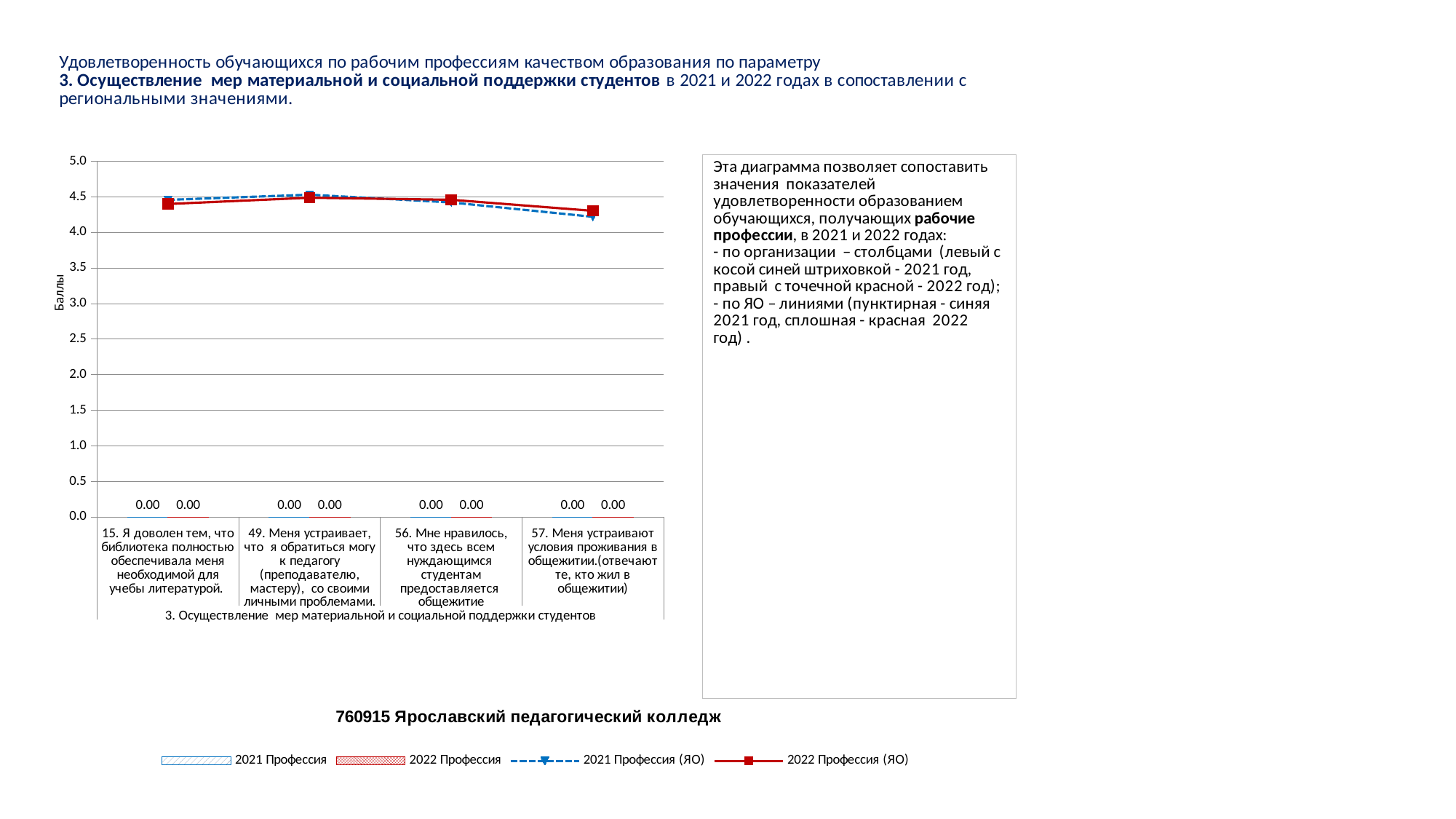
How many categories are shown on the x axis of the chart? 4 What is the value of the 2022 Профессия bar for category "57. Меня устраивают условия проживания в общежитии"? 0.00 What is the label of the vertical axis of the chart? Баллы Which is larger for the 2021 Профессия (ЯО) line: the value for category 15 or the value for category 57? Category 15 What is the value of the 2021 Профессия bar for category "15. Я доволен тем, что библиотека полностью обеспечивала меня необходимой для учебы литературой."? 0.00 What kind of chart is shown on the slide? A combined bar and line chart How many series does the chart legend list? 4 For which category is the 2021 Профессия (ЯО) line lowest? 57. Меня устраивают условия проживания в общежитии Is the value of the 2022 Профессия (ЯО) line for category 15 greater or less than 4.0? greater What is the total of the 2021 Профессия and 2022 Профессия bars for category 15? 0.00 Is the value of the 2021 Профессия (ЯО) line for category 57 greater or less than 4.5? less Does the 2022 Профессия (ЯО) line rise or fall from category 49 to category 57? falls